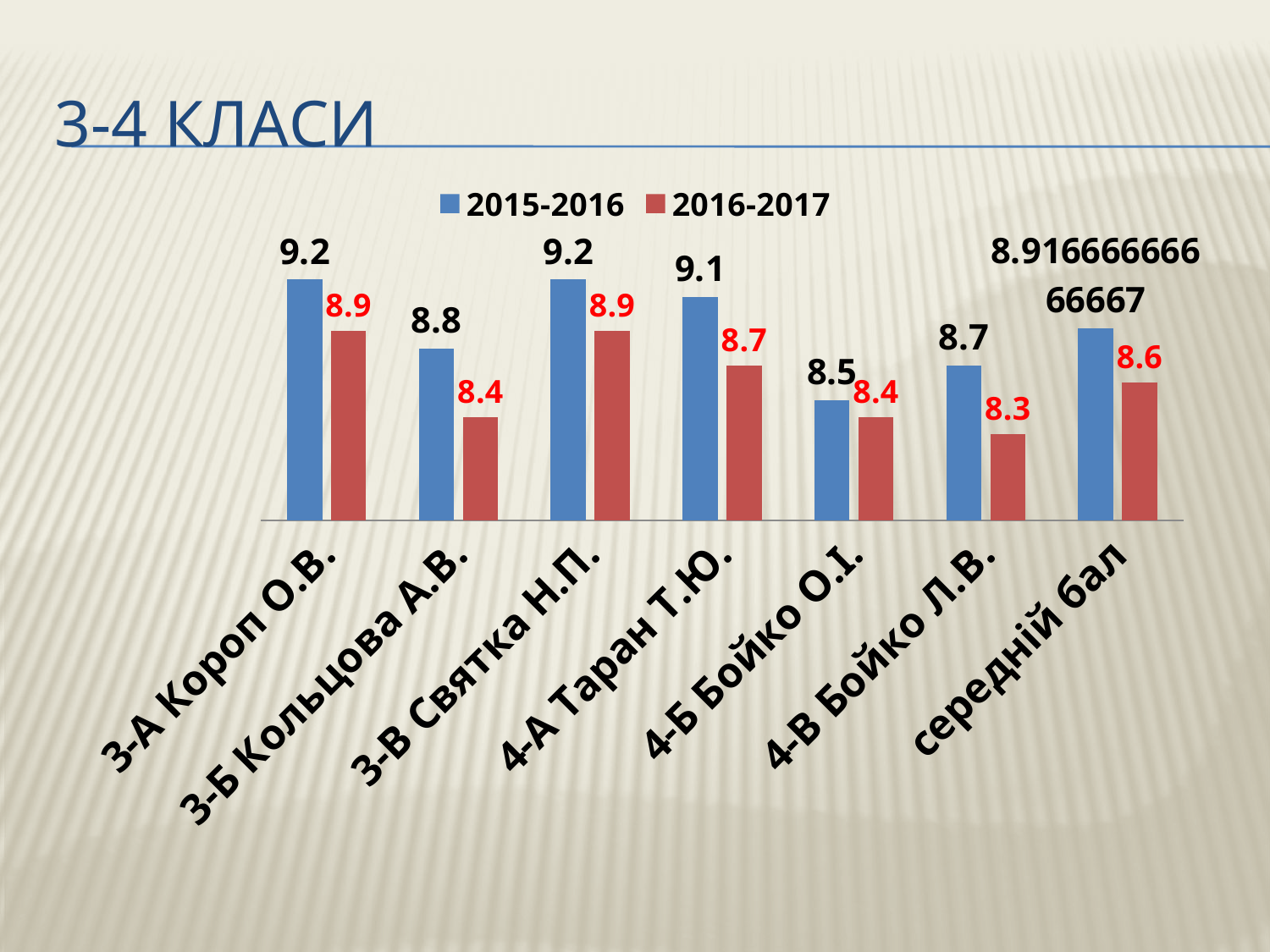
What is the 2016-2017 value for 4-А Таран Т.Ю.? 8.7 What kind of chart is shown on the slide? bar chart How many categories are shown along the x axis? 7 What is the 2016-2017 value for середній бал? 8.6 What are the two series named in the legend? 2015-2016 and 2016-2017 Which category has the lowest 2015-2016 value? 4-Б Бойко О.І. Which category has the lowest 2016-2017 value? 4-В Бойко Л.В. How many series does the legend list? 2 Which colour represents the 2016-2017 series? red Which is larger for 4-В Бойко Л.В.: the 2015-2016 value or the 2016-2017 value? 2015-2016 What is the difference between the 2015-2016 and 2016-2017 values for 3-Б Кольцова А.В.? 0.4 What is the 2015-2016 value for 3-Б Кольцова А.В.? 8.8